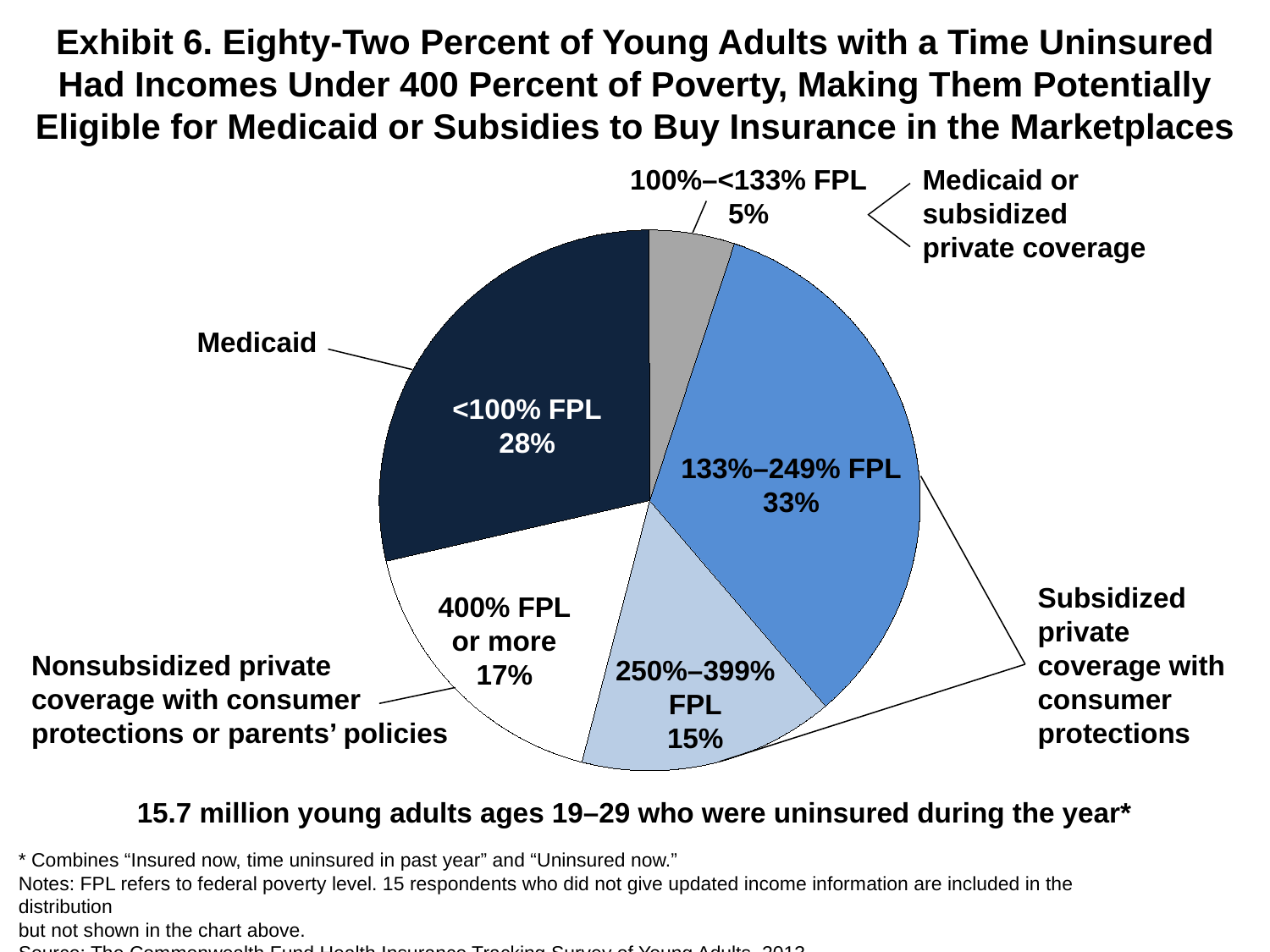
What share is shown for the 100%–<133% FPL slice? 5% What type of chart is shown on the slide? Pie chart What percentage of young adults with a time uninsured had incomes of 400% FPL or more? 17% How many income groups are shown in the pie chart? 5 Which income group has the smallest slice of the pie? 100%–<133% FPL Which income group has the largest slice of the pie? 133%–249% FPL Which coverage category is labeled for the <100% FPL slice? Medicaid What is the difference in percentage points between the 133%–249% FPL slice and the <100% FPL slice? 5 Which slice is larger: 400% FPL or more, or 250%–399% FPL? 400% FPL or more What share is shown for the 250%–399% FPL slice? 15% What percentage of the pie is the 133%–249% FPL slice? 33% What share of young adults with a time uninsured had incomes under 100% FPL? 28%